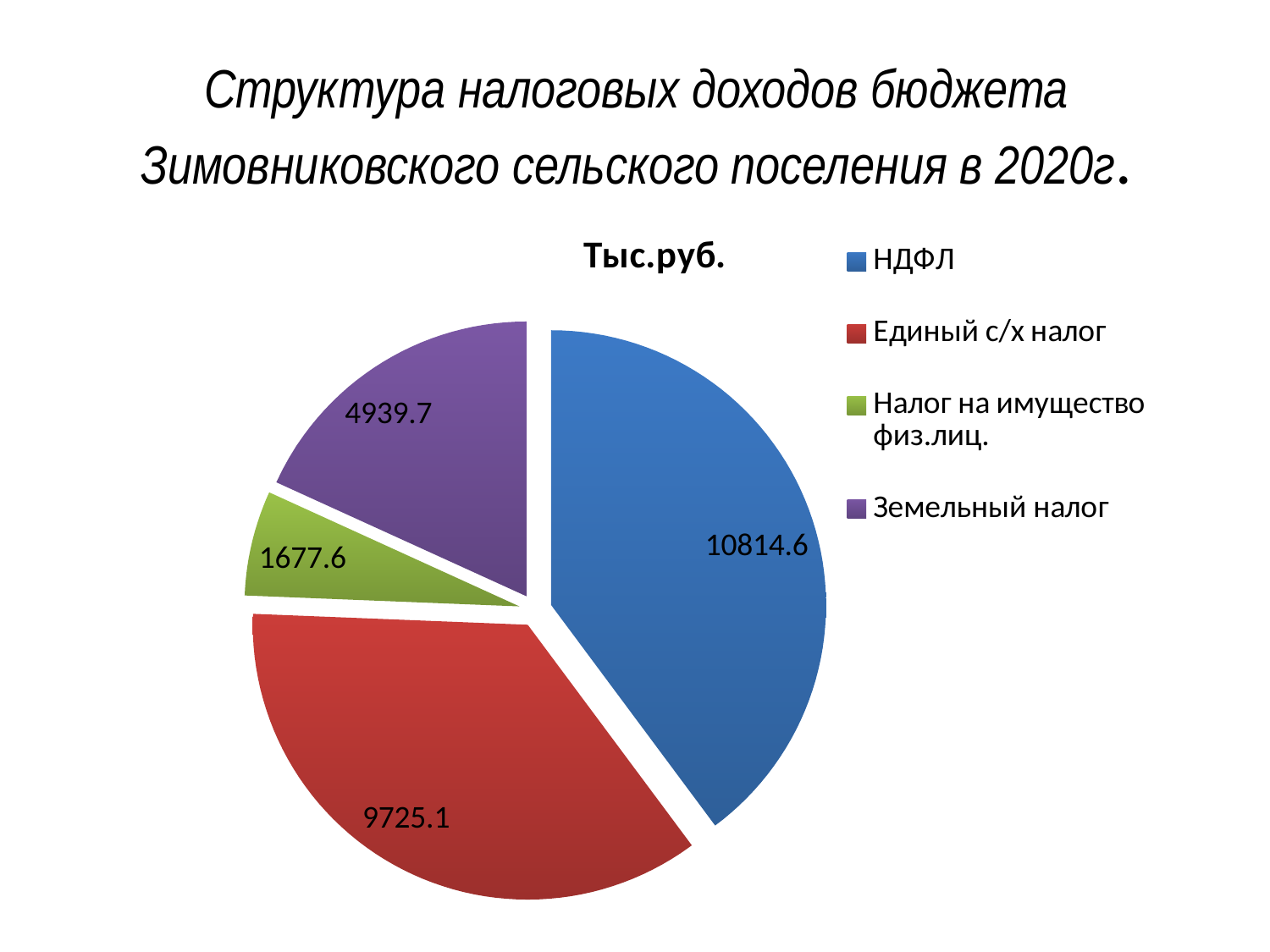
What is the difference between the values for НДФЛ and Единый с/х налог? 1089.5 Which category has the largest slice of the pie? НДФЛ What is the value for Земельный налог? 4939.7 Which is larger, the value for Земельный налог or the value for Единый с/х налог? Единый с/х налог What is the value for Налог на имущество физ.лиц.? 1677.6 What is the value for НДФЛ? 10814.6 Which category has the smallest slice of the pie? Налог на имущество физ.лиц. What is the title shown above the pie chart? Тыс.руб. What is the difference between the values for Земельный налог and Налог на имущество физ.лиц.? 3262.1 How many categories does the pie chart have? 4 What is the value for Единый с/х налог? 9725.1 What type of chart is shown on the slide? Pie chart